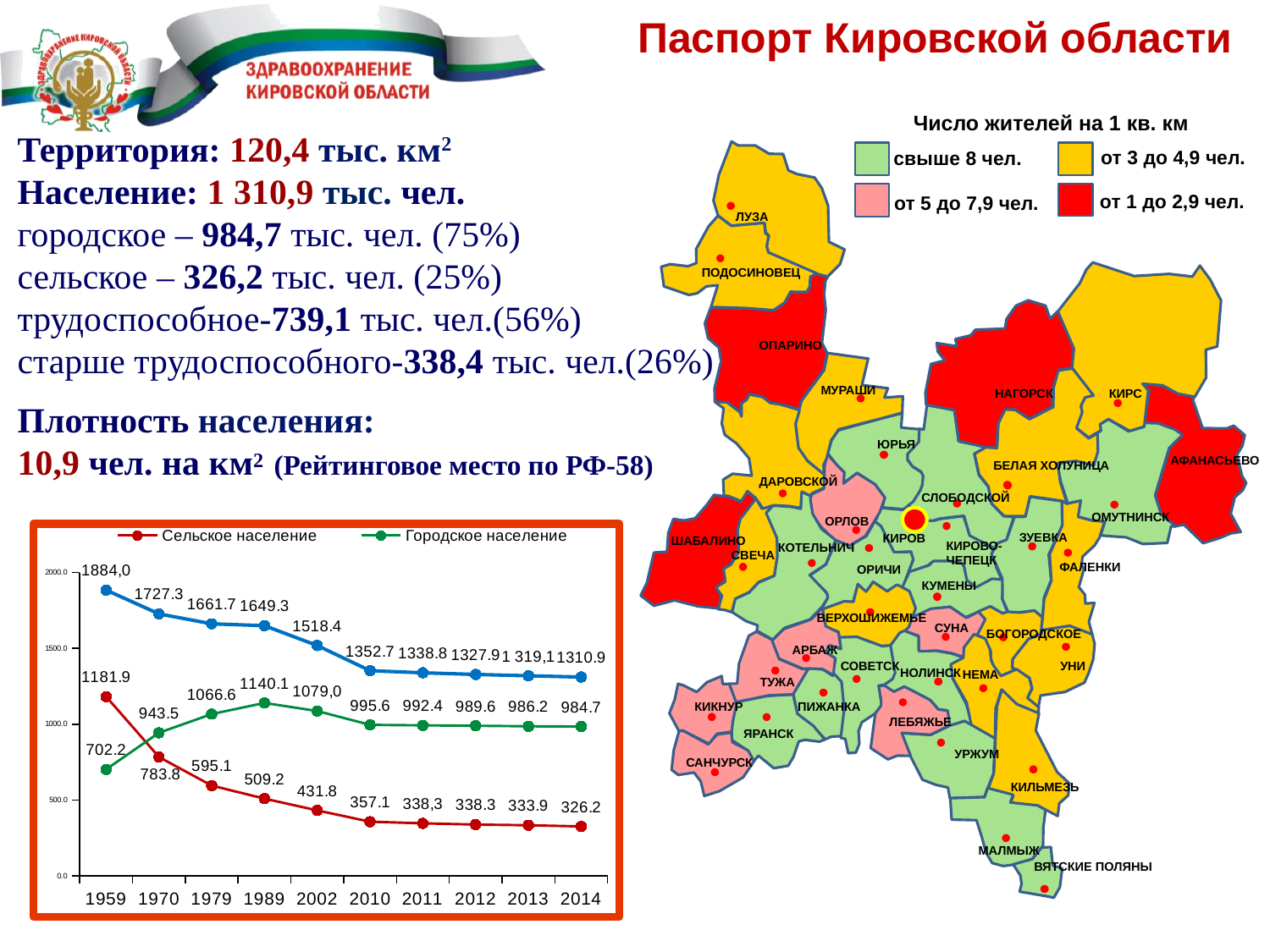
In 1970, which is larger: Городское население or Сельское население? Городское население Does Сельское население rise or fall from 1959 to 2014? fall In which year is Сельское население highest? 1959 How many years are shown on the x axis of the chart? 10 What colour is the line for Сельское население? red In which year is Городское население lowest? 1959 What is the value for Сельское население in 2014? 326.2 What kind of chart is shown on the slide? line chart How many series does the chart legend list? 2 What is the value for Сельское население in 2002? 431.8 What is the difference between Городское население and Сельское население in 2014? 658.5 What is the value for Городское население in 1989? 1140.1